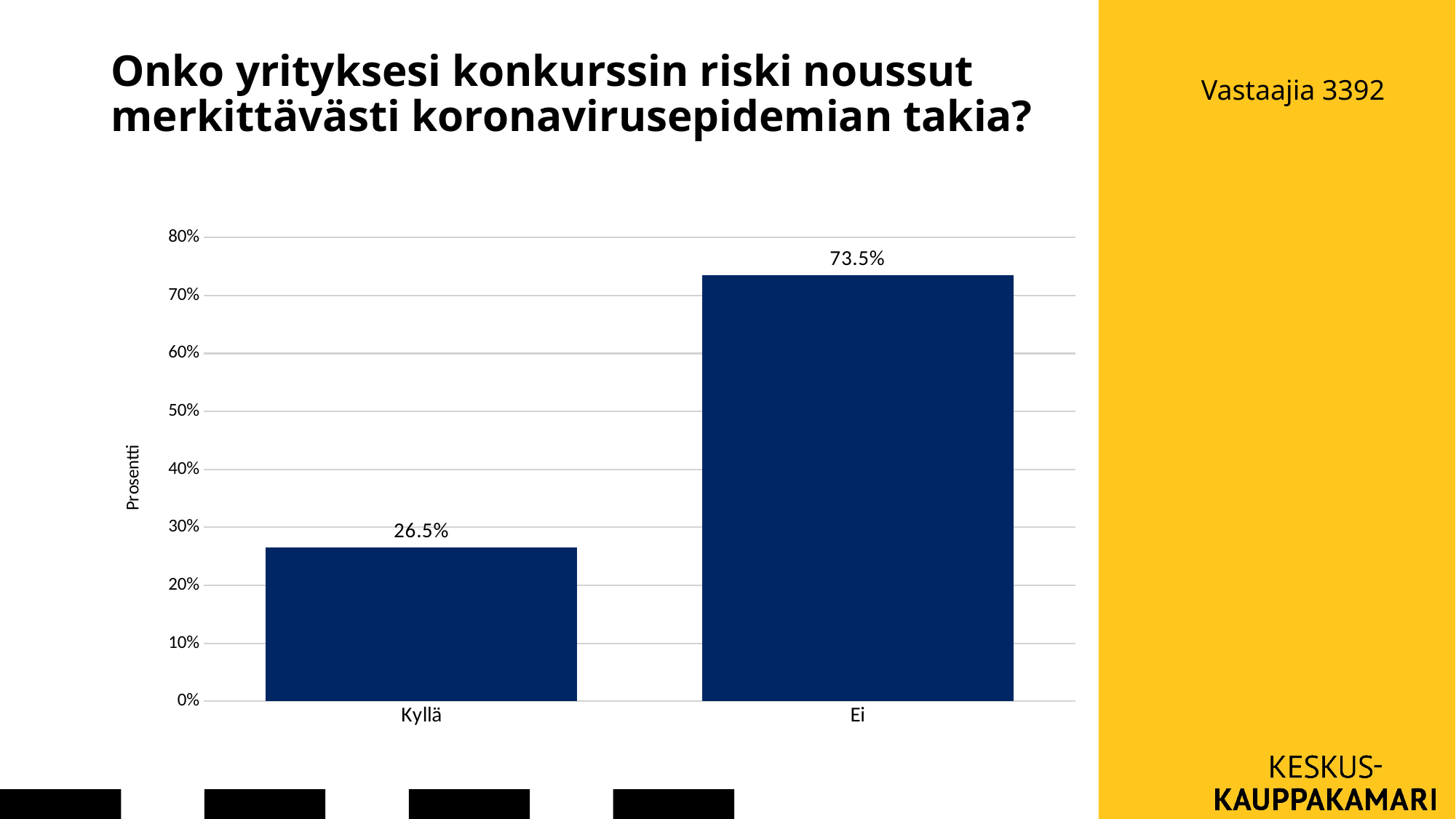
What kind of chart is shown on the slide? bar chart What is the value for Kyllä? 26.5% Which category has the lowest value? Kyllä Is the value for Kyllä greater or less than 30%? less Which is larger, the value for Kyllä or the value for Ei? Ei What is the difference between the values for Ei and Kyllä? 47% Which category has the highest value? Ei What is the value for Ei? 73.5% How many categories are shown on the x axis? 2 How many respondents (Vastaajia) are stated on the slide? 3392 What is the label of the y axis? Prosentti Is the value for Ei greater or less than 70%? greater